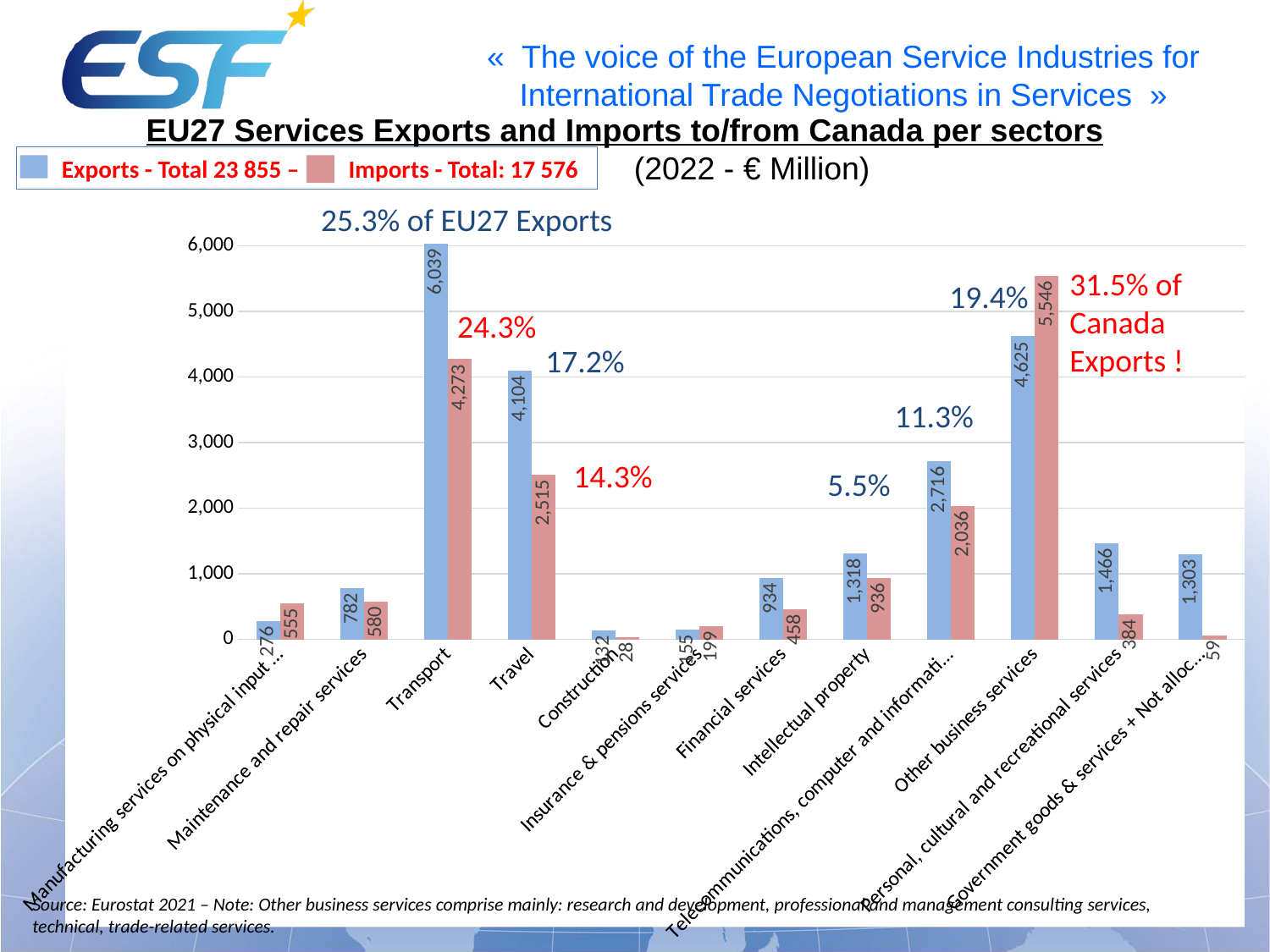
For Other business services, which is larger, Exports or Imports? Imports What is the value of Exports for Transport? 6,039 Which sector has the highest Imports value? Other business services What is the difference between Exports and Imports for Transport? 1,766 How many sectors are shown on the x axis? 12 How many series does the legend list? 2 What is the value of Imports for Travel? 2,515 What kind of chart is shown on the slide? bar chart Which sector has the highest Exports value? Transport Is the Exports value for Telecommunications, computer and information services greater or less than 2,000? greater What is the value of Imports for Other business services? 5,546 What is the value of Exports for Financial services? 934